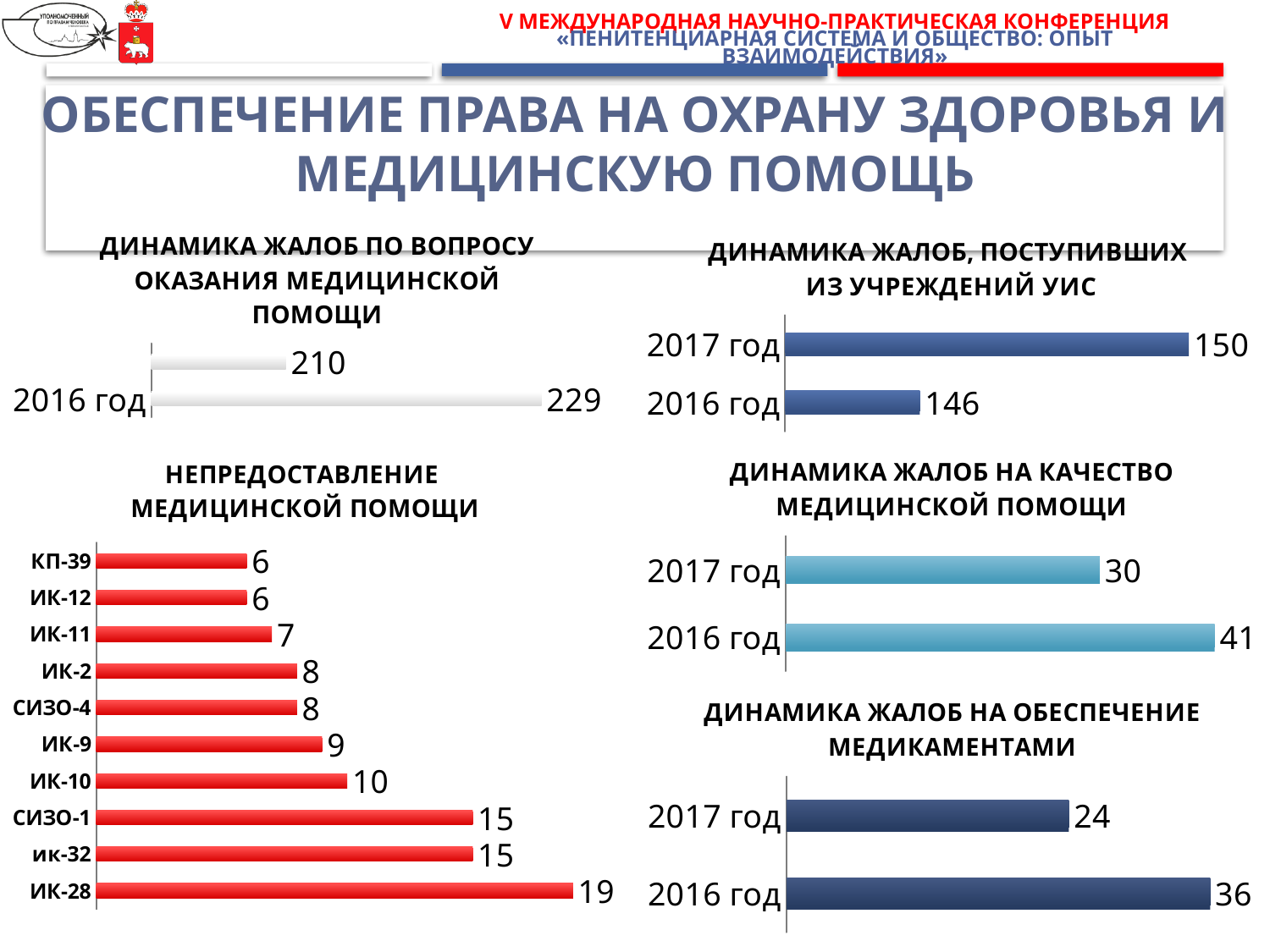
In the chart titled «НЕПРЕДОСТАВЛЕНИЕ МЕДИЦИНСКОЙ ПОМОЩИ», what is the value for ИК-10? 10 In the chart titled «ДИНАМИКА ЖАЛОБ, ПОСТУПИВШИХ ИЗ УЧРЕЖДЕНИЙ УИС», what is the value for 2017 год? 150 In the chart titled «ДИНАМИКА ЖАЛОБ НА ОБЕСПЕЧЕНИЕ МЕДИКАМЕНТАМИ», what is the value for 2016 год? 36 How many categories are shown in the chart titled «НЕПРЕДОСТАВЛЕНИЕ МЕДИЦИНСКОЙ ПОМОЩИ»? 10 In the chart titled «ДИНАМИКА ЖАЛОБ ПО ВОПРОСУ ОКАЗАНИЯ МЕДИЦИНСКОЙ ПОМОЩИ», what is the value for 2016 год? 229 In the chart titled «НЕПРЕДОСТАВЛЕНИЕ МЕДИЦИНСКОЙ ПОМОЩИ», what is the difference between the values for ИК-28 and СИЗО-1? 4 In the chart titled «ДИНАМИКА ЖАЛОБ, ПОСТУПИВШИХ ИЗ УЧРЕЖДЕНИЙ УИС», what is the difference between the 2017 год and 2016 год values? 4 What type of chart is the one titled «НЕПРЕДОСТАВЛЕНИЕ МЕДИЦИНСКОЙ ПОМОЩИ»? Bar chart In the chart titled «ДИНАМИКА ЖАЛОБ НА КАЧЕСТВО МЕДИЦИНСКОЙ ПОМОЩИ», which year has the larger value, 2017 год or 2016 год? 2016 год In the chart titled «ДИНАМИКА ЖАЛОБ НА ОБЕСПЕЧЕНИЕ МЕДИКАМЕНТАМИ», what is the difference between the 2016 год and 2017 год values? 12 In the chart titled «НЕПРЕДОСТАВЛЕНИЕ МЕДИЦИНСКОЙ ПОМОЩИ», which category has the highest value? ИК-28 In the chart titled «ДИНАМИКА ЖАЛОБ НА КАЧЕСТВО МЕДИЦИНСКОЙ ПОМОЩИ», what is the value for 2017 год? 30